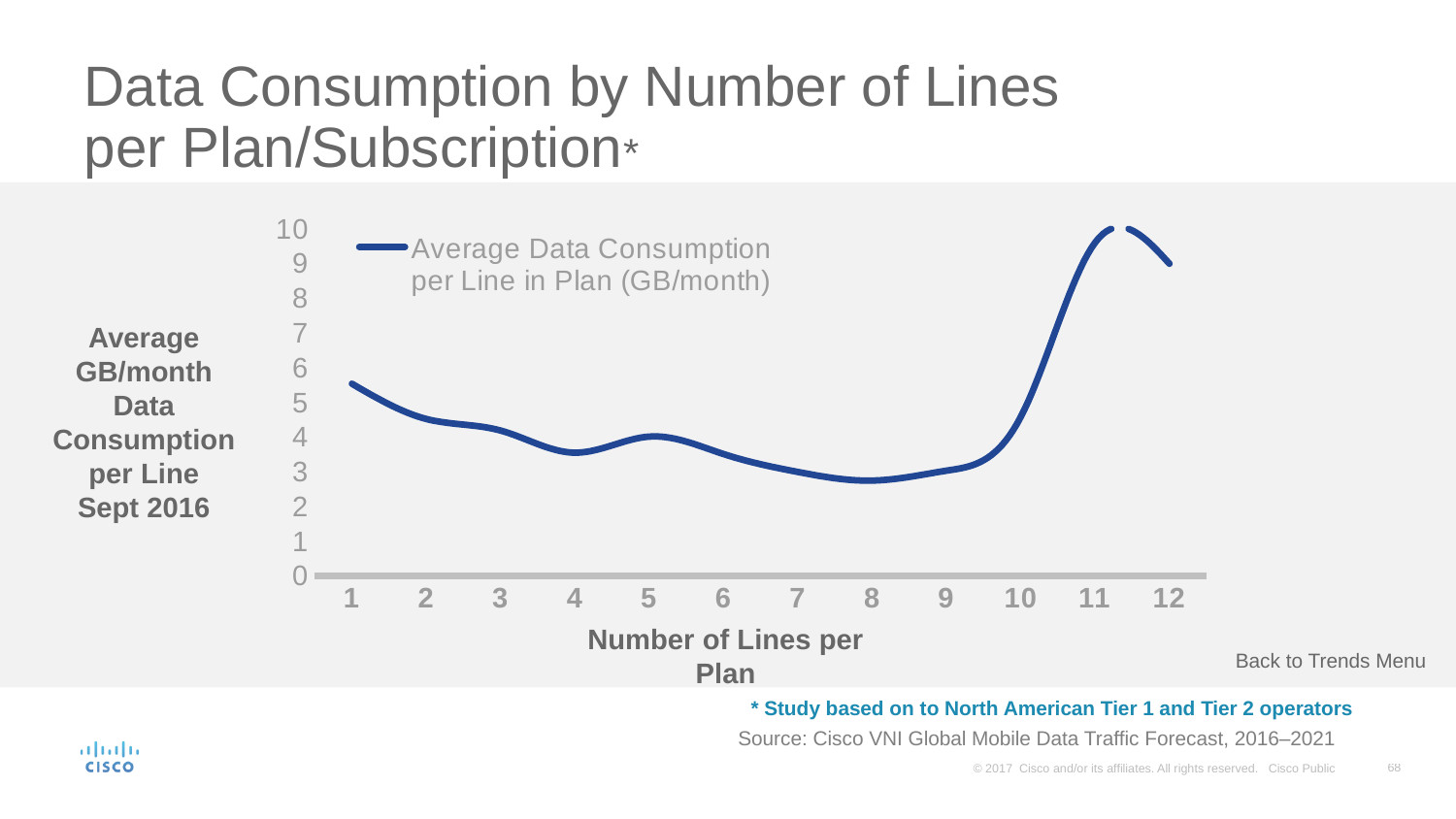
What kind of chart is shown on the slide? line chart At which number of lines per plan is the average data consumption per line highest? 11 How many points (numbers of lines per plan) are plotted along the x axis? 12 At which number of lines per plan is the average data consumption per line lowest? 8 Does the average data consumption per line rise or fall as the number of lines per plan goes from 1 to 8? fall Is the average data consumption per line for 8 lines per plan greater or less than 4 GB/month? less What is the name of the series shown in the legend? Average Data Consumption per Line in Plan (GB/month) Is the average data consumption per line for 11 lines per plan greater or less than 9 GB/month? greater Which has higher average data consumption per line: 1 line per plan or 8 lines per plan? 1 line per plan Is the average data consumption per line for 1 line per plan greater or less than 5 GB/month? greater How many series does the legend list? 1 What is the title of the x axis? Number of Lines per Plan